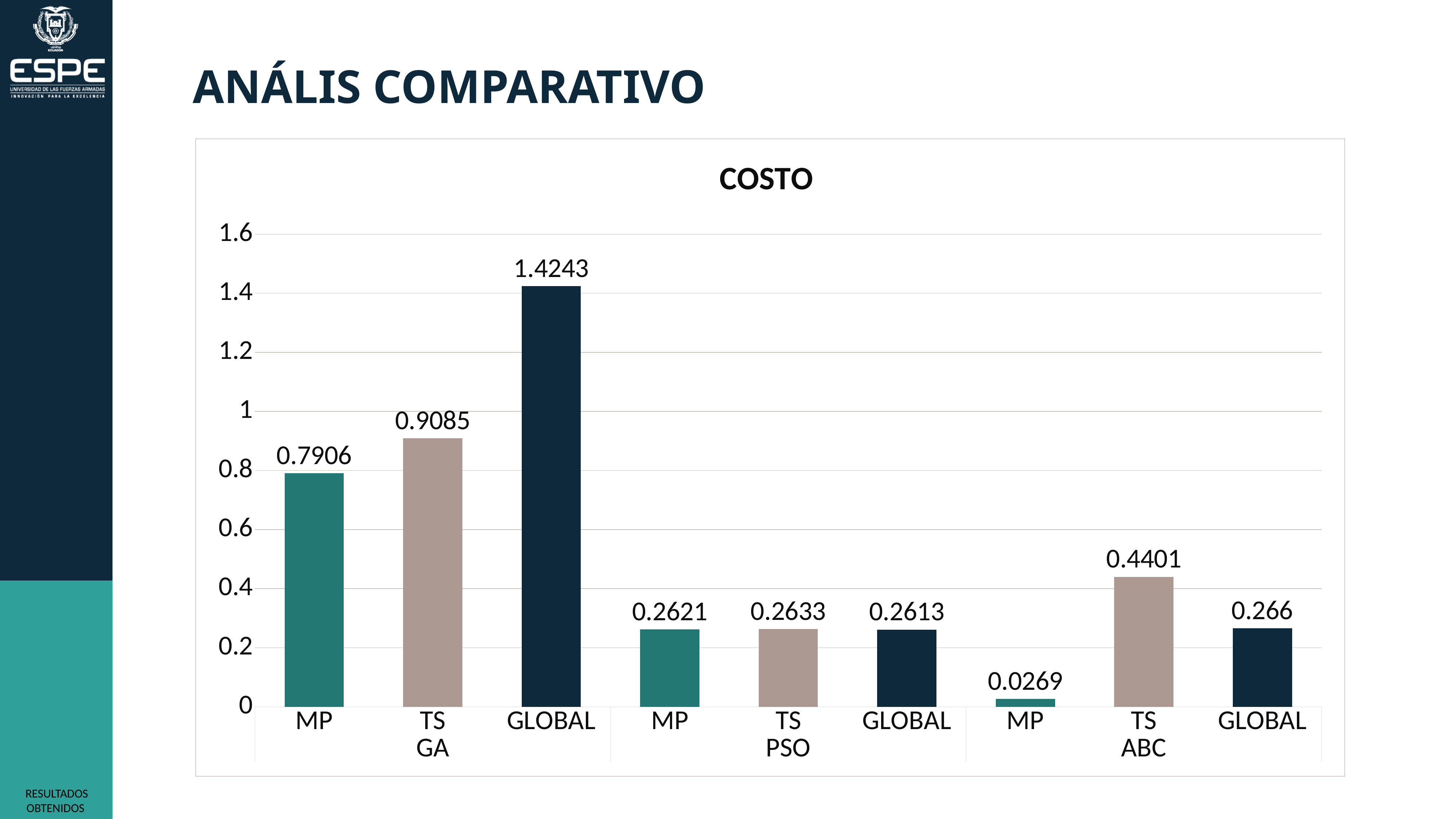
What is the value for MP in the ABC group? 0.0269 What is the title of the chart? COSTO What type of chart is shown on the slide? bar chart What is the value for TS in the PSO group? 0.2633 How many bars are plotted in the chart? 9 What is the difference between the GLOBAL and MP values in the GA group? 0.6337 Which bar has the lowest value in the chart? MP (ABC) What is the value for TS in the ABC group? 0.4401 How many groups (GA, PSO, ABC) are shown on the x axis? 3 Which bar has the highest value in the chart? GLOBAL (GA) Which is larger, the TS value in the GA group or the TS value in the ABC group? TS in the GA group What is the value for GLOBAL in the GA group? 1.4243